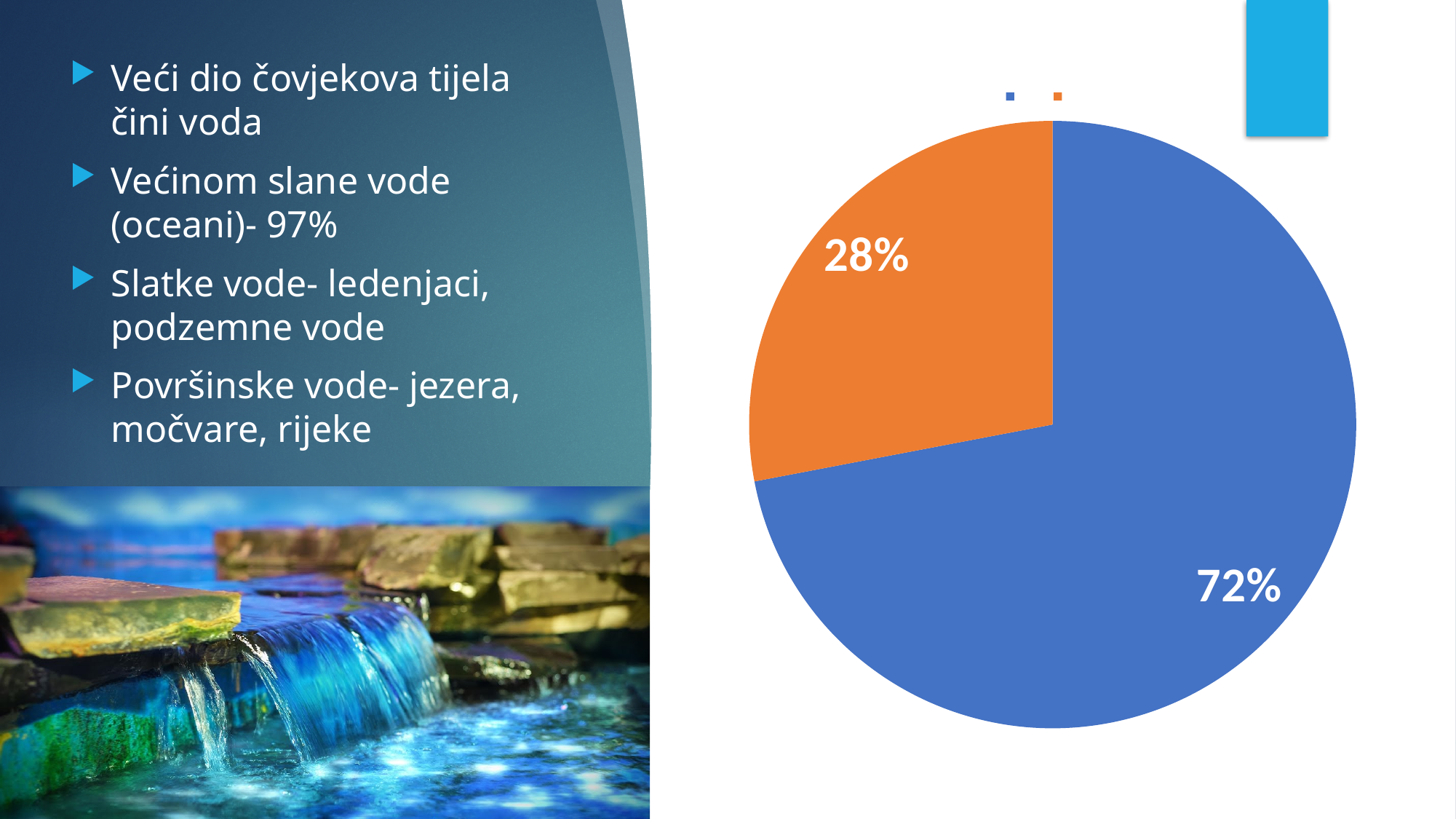
How many entries does the legend of the pie chart show? 2 Is the value of the orange slice in the pie chart greater or less than 50%? less Which slice of the pie chart is the smallest? the orange slice What colour is the slice labelled 72% in the pie chart? blue How many slices does the pie chart have? 2 What share of the pie does the orange slice represent? 28% By how many percentage points does the blue slice exceed the orange slice in the pie chart? 44 percentage points What kind of chart is shown on the slide? pie chart Which slice is larger in the pie chart, the blue one or the orange one? the blue one What percentage is shown on the blue slice of the pie chart? 72% Which slice of the pie chart is the largest? the blue slice What percentage is shown on the orange slice of the pie chart? 28%